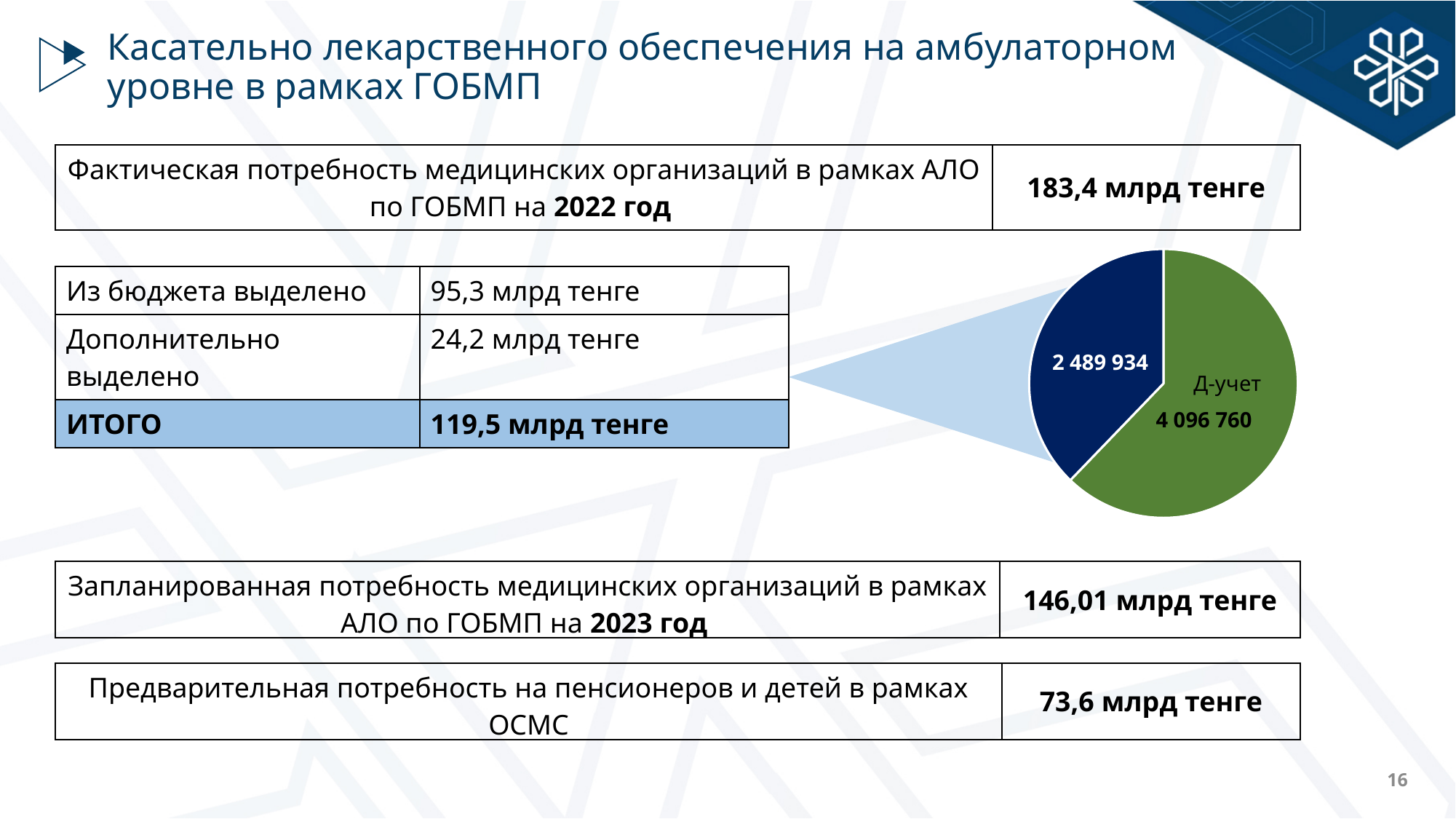
Which slice of the pie chart is the largest? Д-учет What colour is the Д-учет slice of the pie chart? green How many slices does the pie chart have? 2 Which is larger in the pie chart: the Д-учет slice or the dark blue slice? Д-учет What is the difference between the Д-учет slice value and the dark blue slice value in the pie chart? 1 606 826 What value is printed on the dark blue slice of the pie chart? 2 489 934 What colour is the slice labelled 2 489 934 in the pie chart? dark blue What value is shown for the Д-учет slice of the pie chart? 4 096 760 What kind of chart is shown on the slide? pie chart What is the sum of the two values shown in the pie chart? 6 586 694